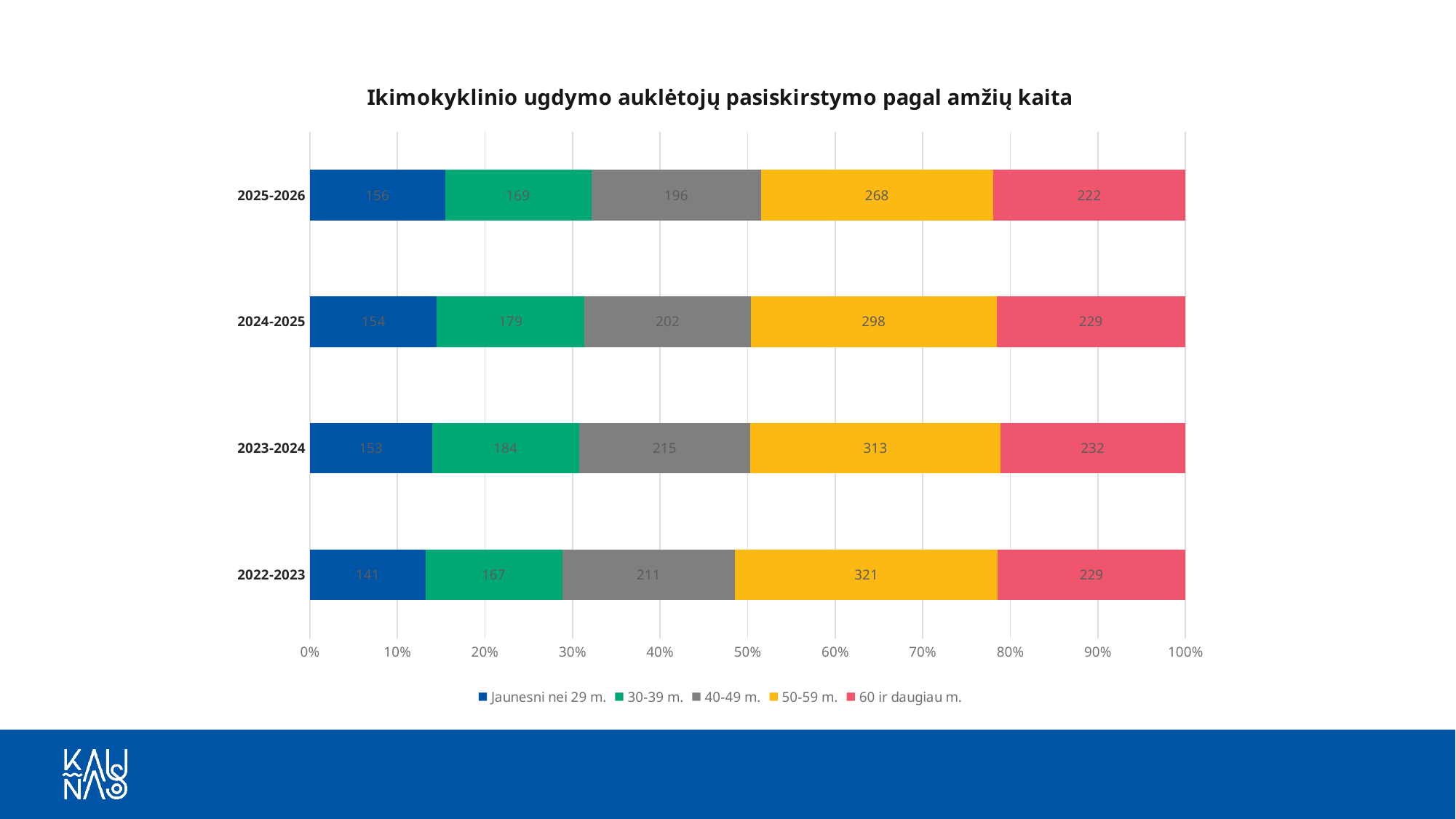
How many series does the legend list? 5 What is the value for the Jaunesni nei 29 m. series in 2022-2023? 141 What is the difference between the 50-59 m. values for 2022-2023 and 2025-2026? 53 Which is larger: the 40-49 m. value in 2023-2024 or in 2024-2025? 2023-2024 In which year is the value for the 50-59 m. series highest? 2022-2023 What kind of chart is shown on the slide? Stacked bar chart In which year is the value for the 30-39 m. series lowest? 2022-2023 What is the total of the stacked bar for 2025-2026? 1011 How many year categories are shown on the chart? 4 What is the value for the 50-59 m. series in 2023-2024? 313 What is the title of the chart? Ikimokyklinio ugdymo auklėtojų pasiskirstymo pagal amžių kaita What is the value for the 60 ir daugiau m. series in 2025-2026? 222